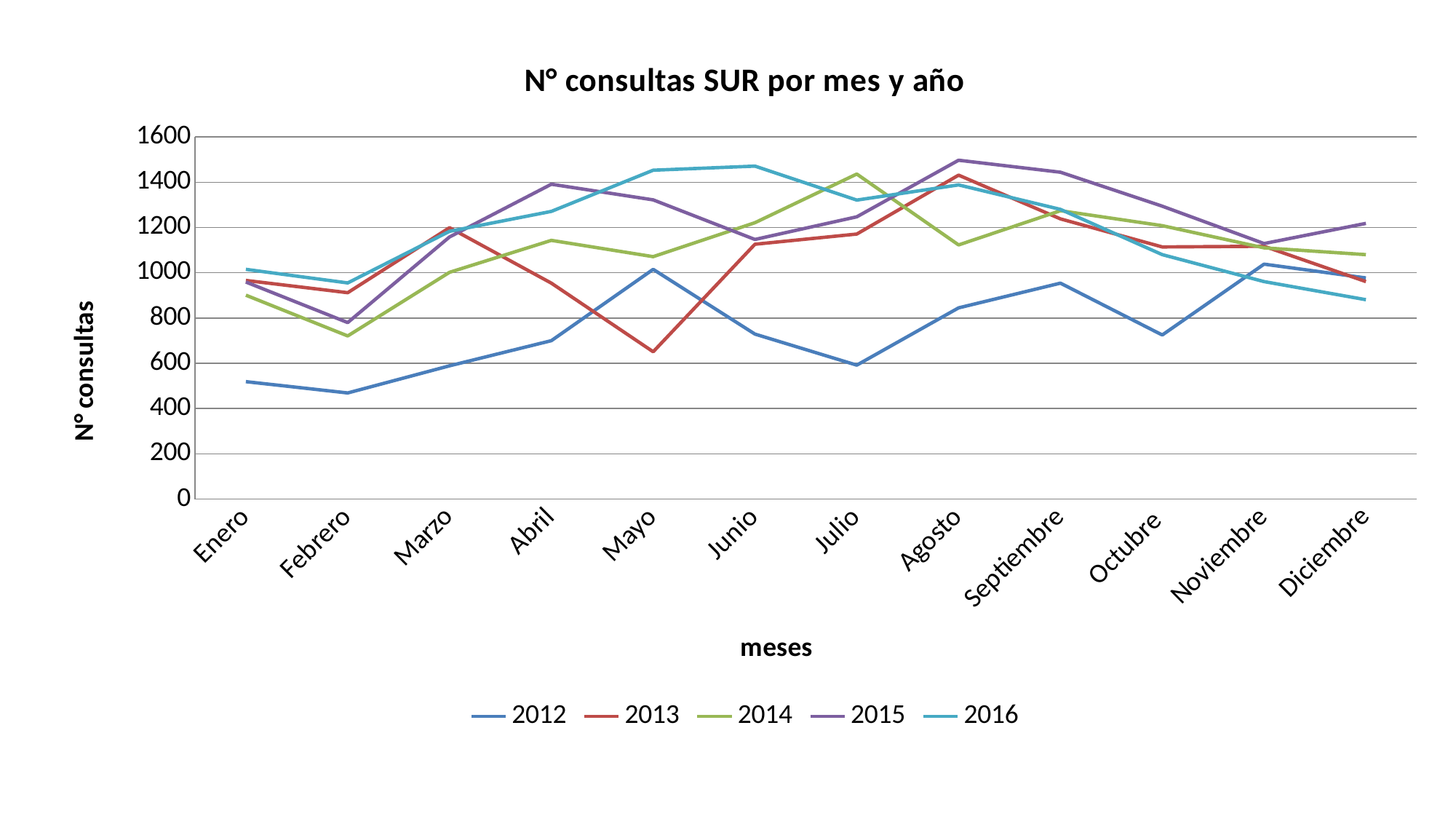
Does the 2012 series rise or fall from Enero to Febrero? fall Is the value for 2012 in Febrero greater or less than 600? less What kind of chart is shown on the slide? line chart How many series does the legend list? 5 Is the value for 2016 in Diciembre greater or less than 1000? less In which month is the 2013 series at its lowest? Mayo In which month is the 2014 series at its highest? Julio In Mayo, which series has the larger value, 2013 or 2016? 2016 What is the title of the chart? N° consultas SUR por mes y año Is the value for 2015 in Agosto greater or less than 1400? greater In which month is the 2012 series at its lowest? Febrero How many months are shown along the x axis? 12